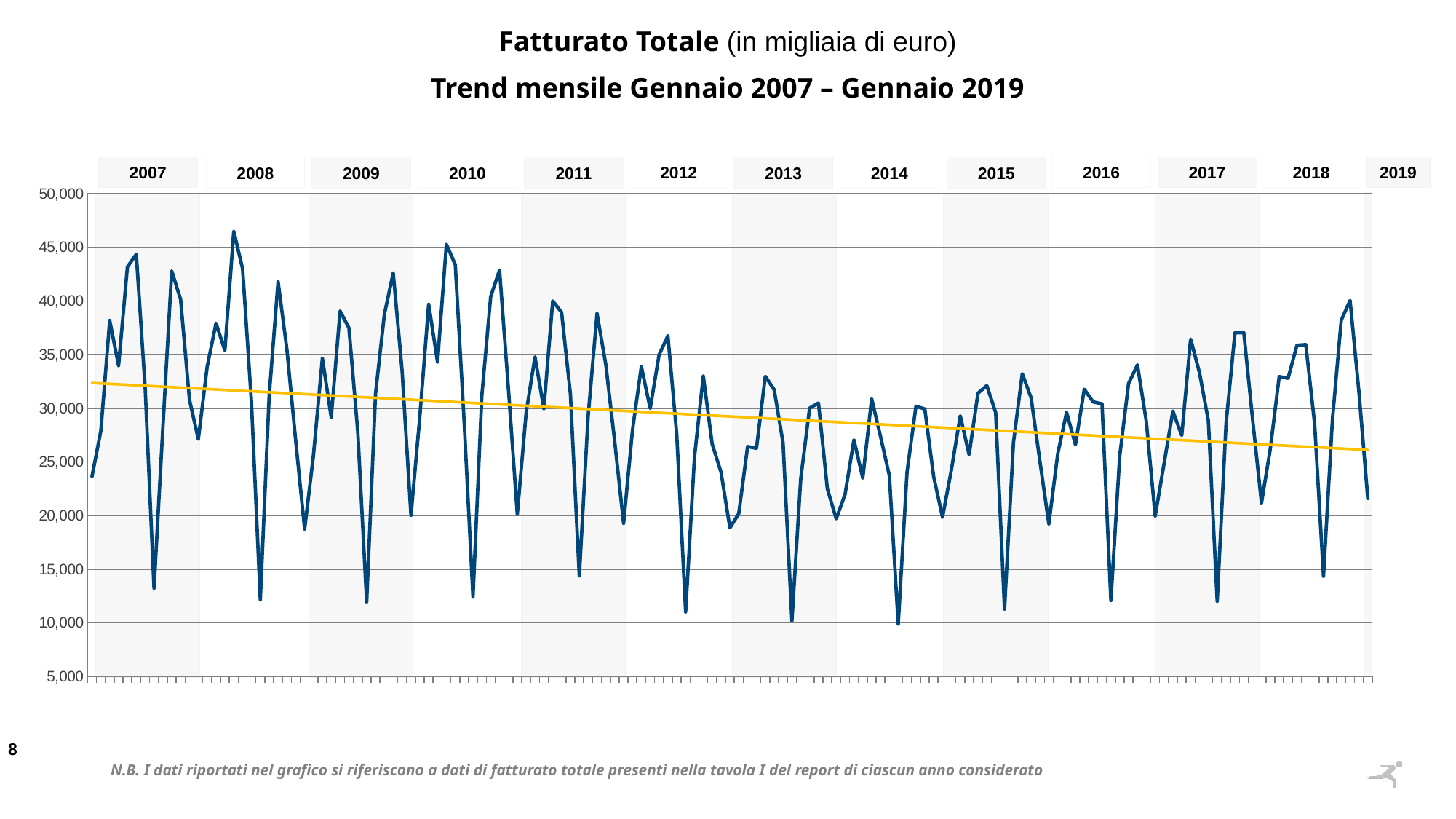
Is the value of the trend line at January 2019 greater or less than 30,000? less Is the value of the trend line at the start of 2007 greater or less than 30,000? greater In which year does the monthly series reach its highest peak? 2008 Does the yellow trend line rise or fall from 2007 to 2019? fall Is the highest peak in 2018 greater or less than 45,000? less What kind of chart is shown on the slide? line chart What is the maximum value shown on the vertical axis? 50,000 Which is higher, the highest peak in 2008 or the highest peak in 2018? 2008 How many year labels are shown along the top of the chart? 13